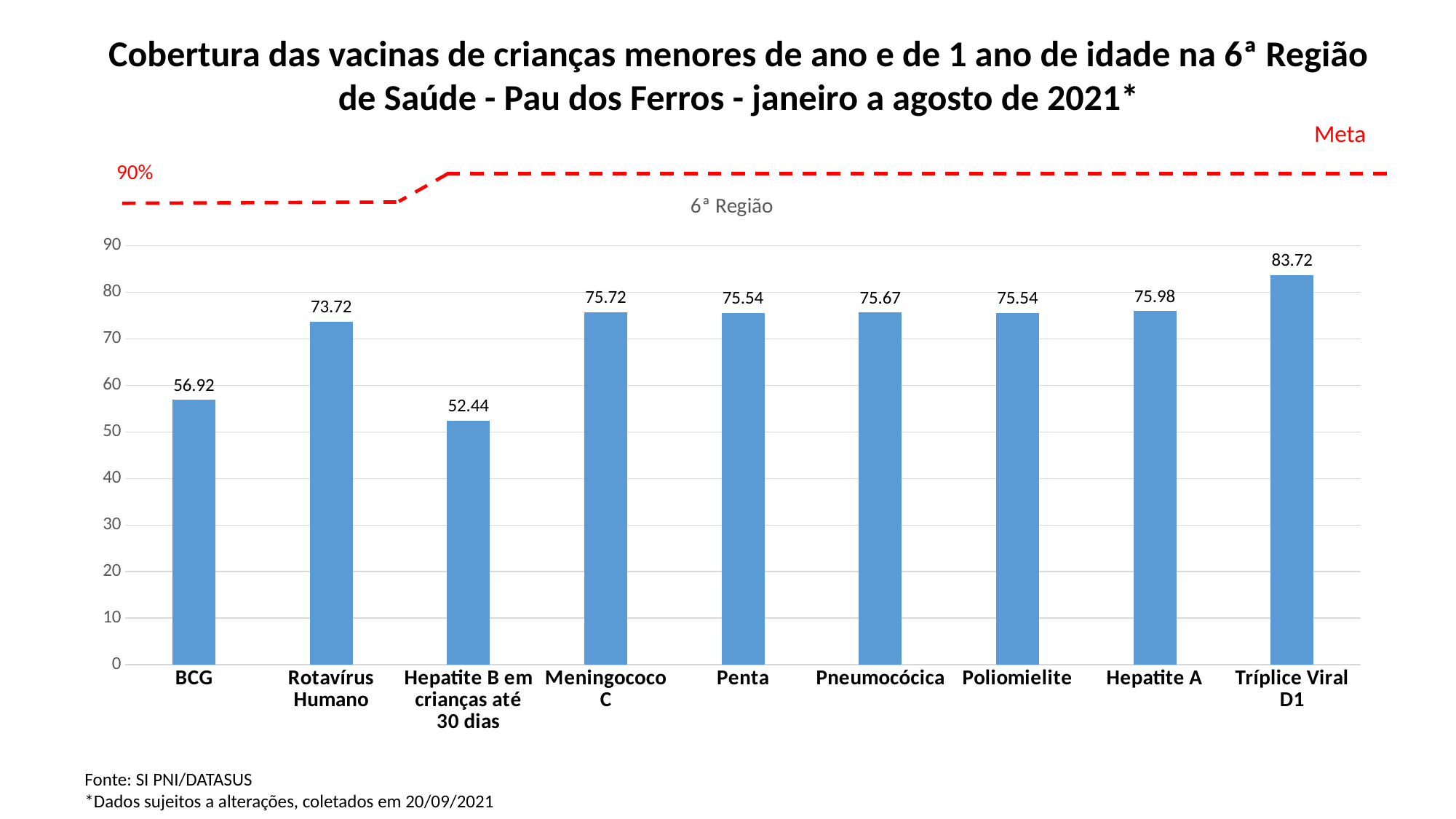
Which is larger, the value for Rotavírus Humano or the value for Meningococo C? Meningococo C What kind of chart is this? bar chart What is the value for Hepatite B em crianças até 30 dias? 52.44 Which category has the highest value? Tríplice Viral D1 Which category has the lowest value? Hepatite B em crianças até 30 dias Is the value for Penta greater or less than 70? greater What is the difference between the values for Tríplice Viral D1 and BCG? 26.8 How many categories are shown on the x axis? 9 What is the value for BCG? 56.92 What is the value for Tríplice Viral D1? 83.72 What target value (Meta) is indicated by the red dashed line? 90% What is the value for Rotavírus Humano? 73.72